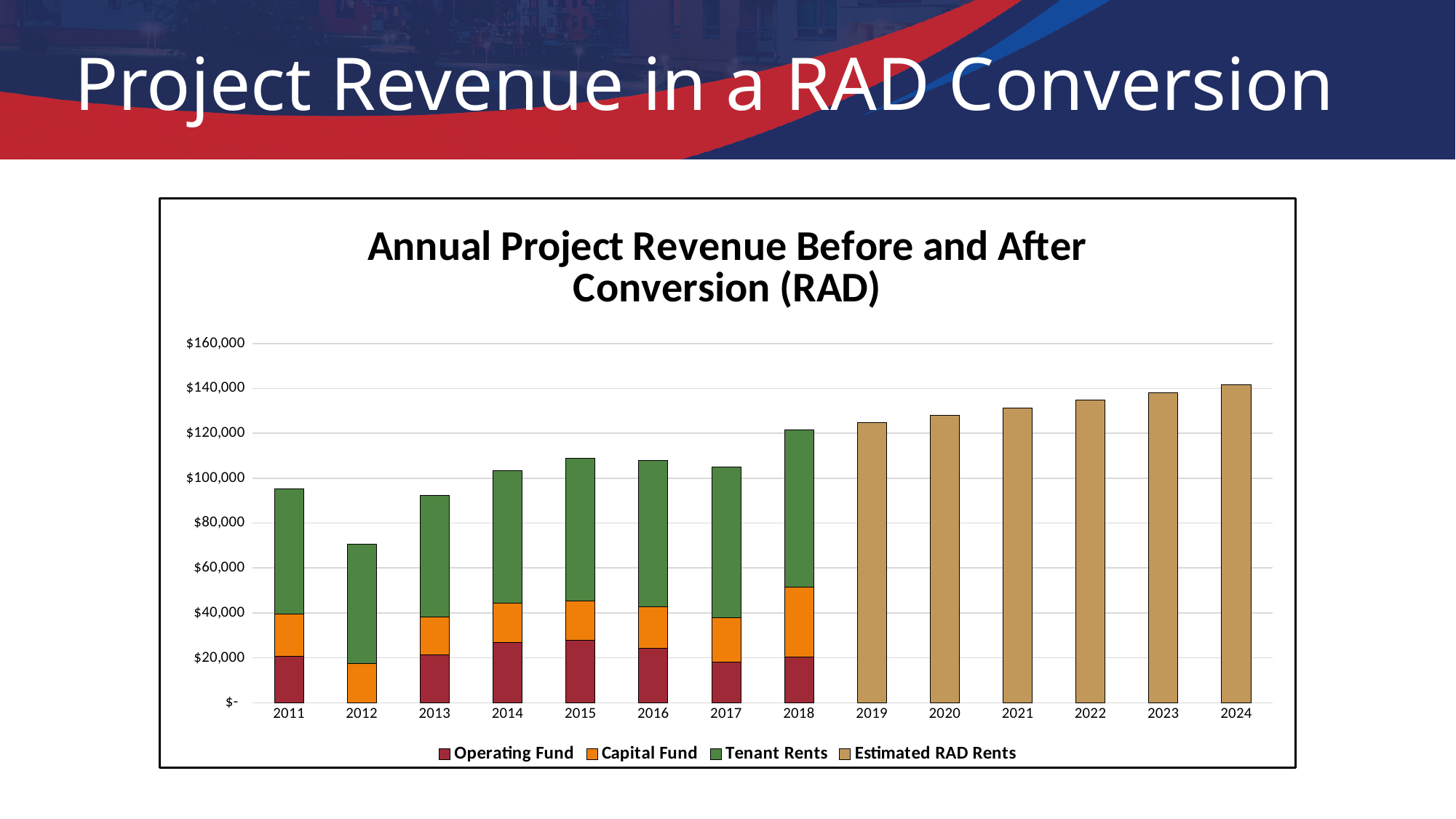
How many years are shown on the x axis? 14 What kind of chart is shown on the slide? Bar chart Is the total revenue for 2018 greater or less than $100,000? greater What is the title of the chart? Annual Project Revenue Before and After Conversion (RAD) How many series does the legend list? 4 Which year has the highest total annual project revenue? 2024 Do the Estimated RAD Rents values rise or fall from 2019 to 2024? rise Is the total revenue for 2012 greater or less than $80,000? less Which year has the lowest total annual project revenue? 2012 Is the total revenue for 2011 greater or less than $100,000? less Which year has the larger total revenue, 2011 or 2012? 2011